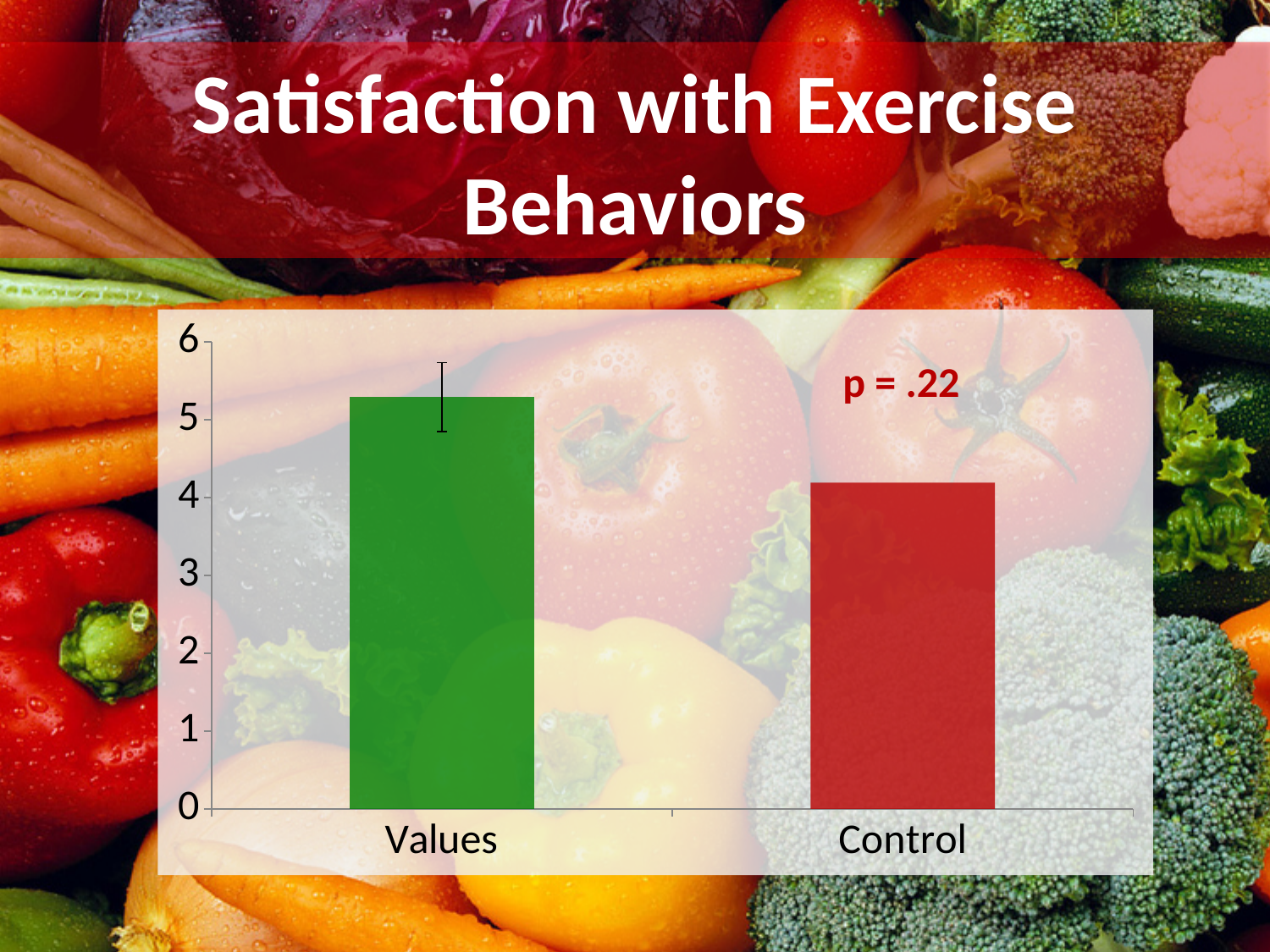
Is the value for Values greater or less than 6? less What p-value is annotated on the chart? p = .22 How many categories are shown on the x axis of the chart? 2 What kind of chart is shown on the slide? bar chart Which bar is taller, Values or Control? Values Which category has the lowest bar in the chart? Control Is the value for Values greater or less than 5? greater Which category has the highest bar in the chart? Values What is the title of the slide containing the chart? Satisfaction with Exercise Behaviors Is the value for Control greater or less than 5? less